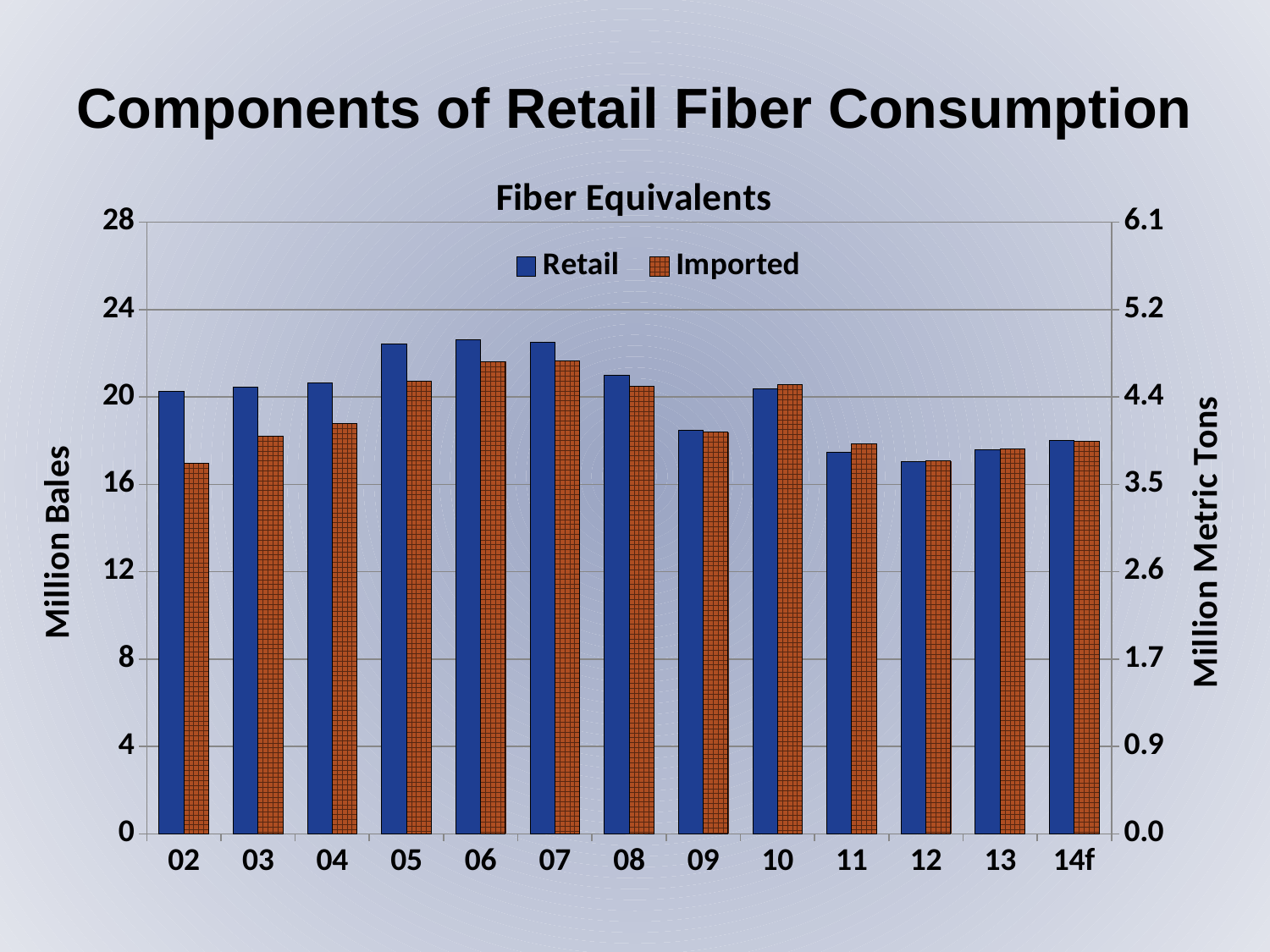
What kind of chart is shown on the slide? bar chart In 02, which is larger, Retail or Imported? Retail Is the Retail value for 12 greater or less than 16 million bales? greater Do the Retail values rise or fall from 07 to 09? fall Is the Imported value for 02 greater or less than 20 million bales? less Is the Retail value for 05 greater or less than 20 million bales? greater In 04, which is larger, Retail or Imported? Retail How many series does the legend list? 2 What is the title of the left vertical axis? Million Bales How many years are shown on the x axis? 13